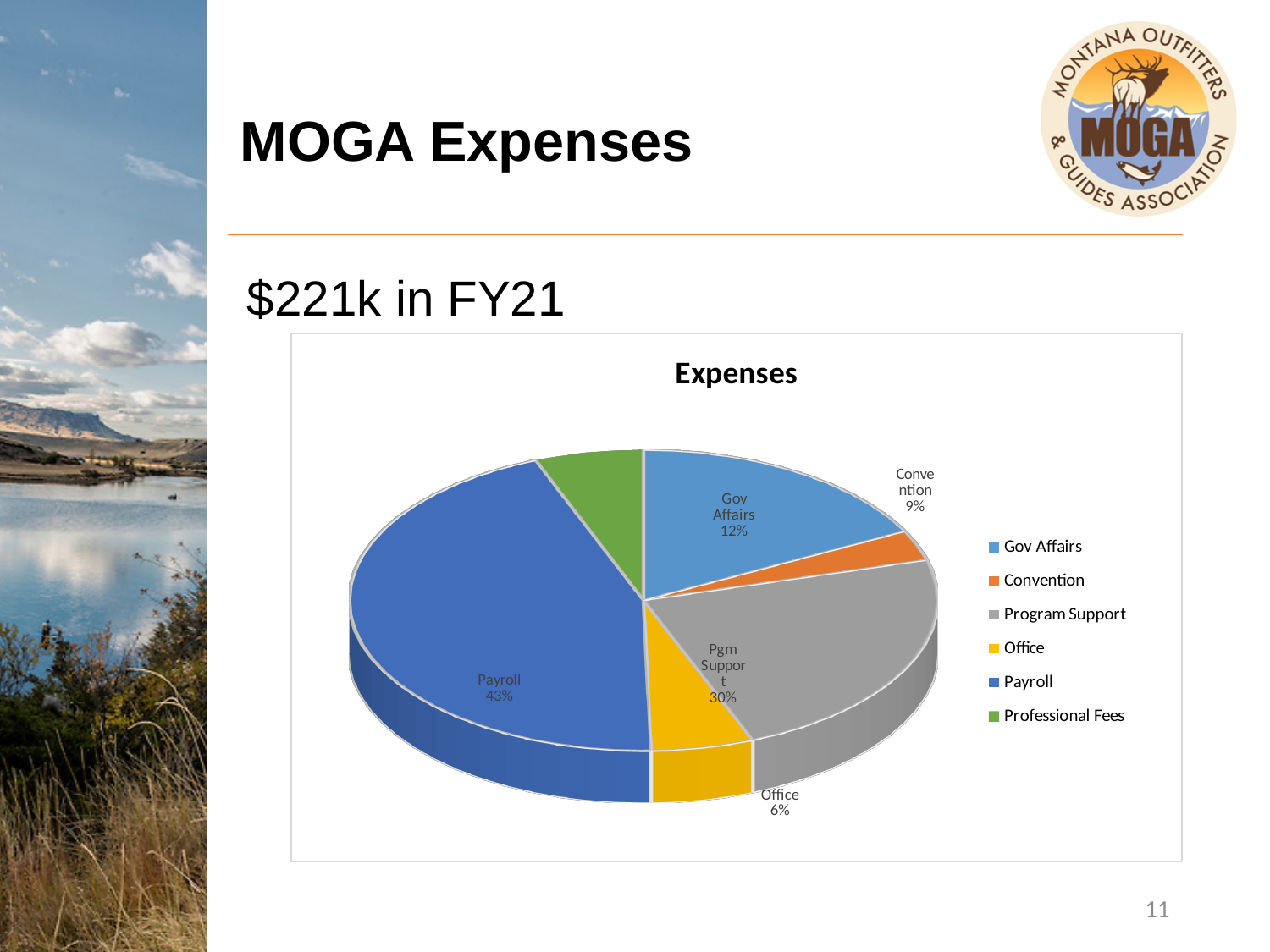
What share of expenses is Gov Affairs? 12% What share of expenses is Program Support? 30% Which expense category has the largest slice of the pie? Payroll How many categories does the legend list? 6 What is the title of the chart? Expenses What share of expenses is Payroll? 43% How many percentage points larger is Payroll than Program Support? 13 percentage points Which is larger, the Payroll slice or the Professional Fees slice? Payroll What share of expenses is Office? 6% What share of expenses is Convention? 9% What kind of chart is shown on the slide? pie chart Which is larger, the Gov Affairs slice or the Office slice? Gov Affairs